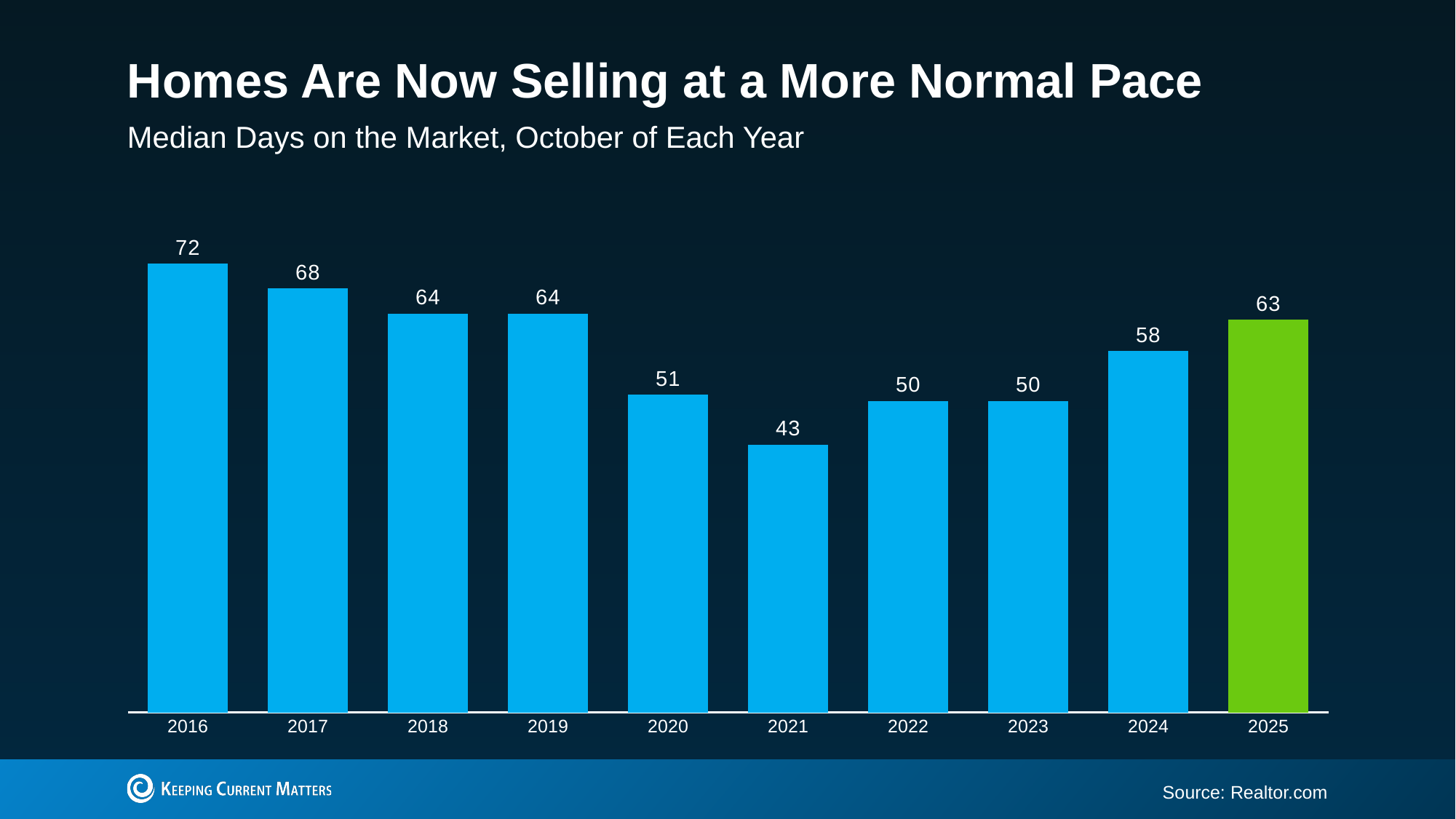
What is the median days on the market for October 2025? 63 What is the difference in median days on the market between 2025 and 2024? 5 What is the median days on the market for October 2021? 43 Which year's bar is shown in green rather than blue? 2025 What kind of chart is shown on the slide? Bar chart Which year has the lowest median days on the market? 2021 Which year has the highest median days on the market? 2016 How many years are shown on the chart? 10 Which year has a higher median days on the market, 2020 or 2024? 2024 What is the median days on the market for October 2016? 72 Do the median days on the market rise or fall from 2016 to 2021? Fall What is the difference in median days on the market between 2016 and 2021? 29